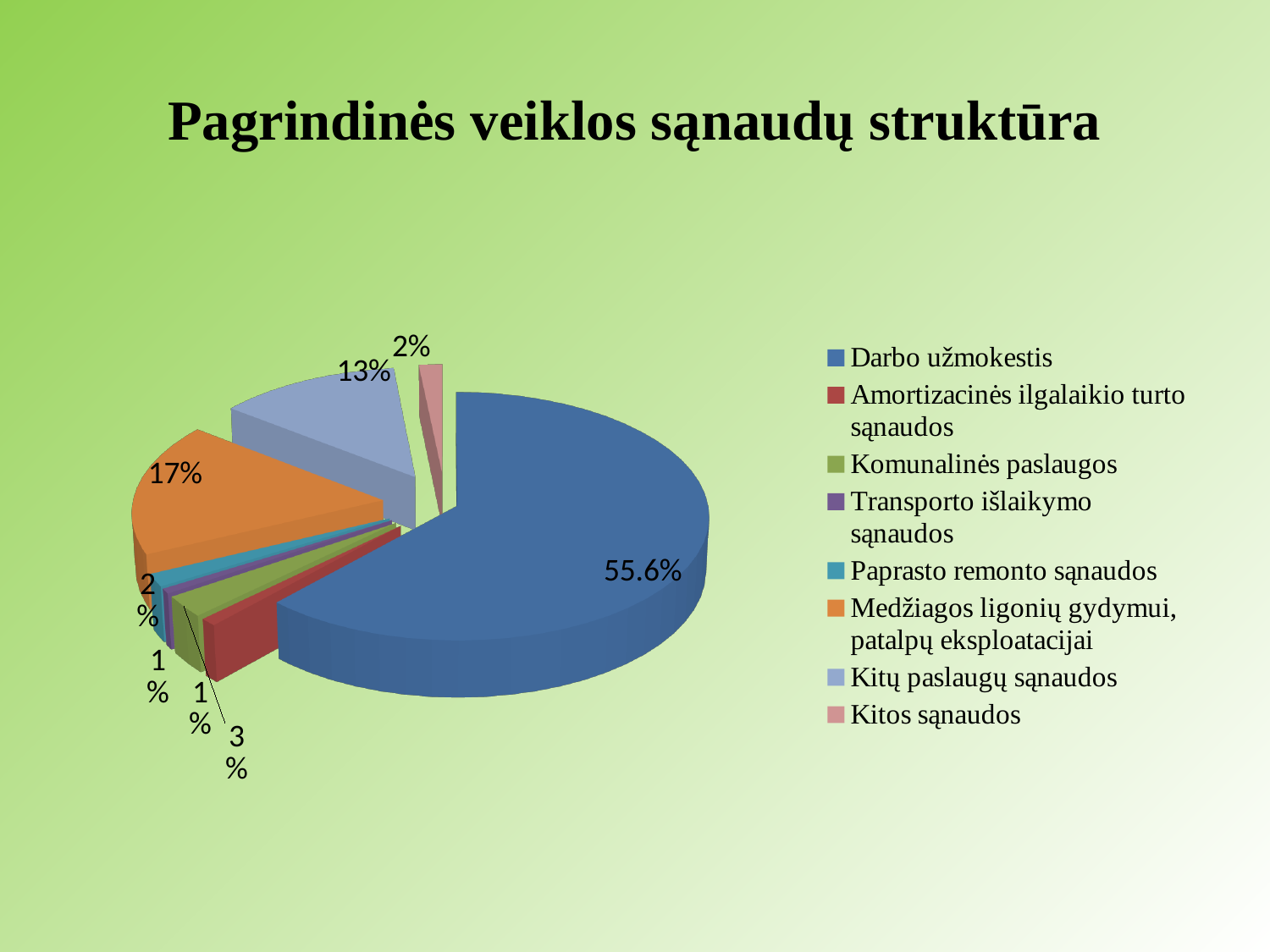
How many entries does the legend list? 8 What percentage is shown for Kitų paslaugų sąnaudos? 13% What is the title of the chart on the slide? Pagrindinės veiklos sąnaudų struktūra Which category has the largest slice of the pie? Darbo užmokestis What share of the pie does Darbo užmokestis have? 55.6% What is the difference in percentage points between Medžiagos ligonių gydymui, patalpų eksploatacijai and Kitų paslaugų sąnaudos? 4 What kind of chart is shown on the slide? pie chart Which is larger: Medžiagos ligonių gydymui, patalpų eksploatacijai or Kitų paslaugų sąnaudos? Medžiagos ligonių gydymui, patalpų eksploatacijai What percentage is shown for Kitos sąnaudos? 2% What percentage is shown for Amortizacinės ilgalaikio turto sąnaudos? 1% How many slices does the pie chart have? 8 What percentage is shown for Medžiagos ligonių gydymui, patalpų eksploatacijai? 17%